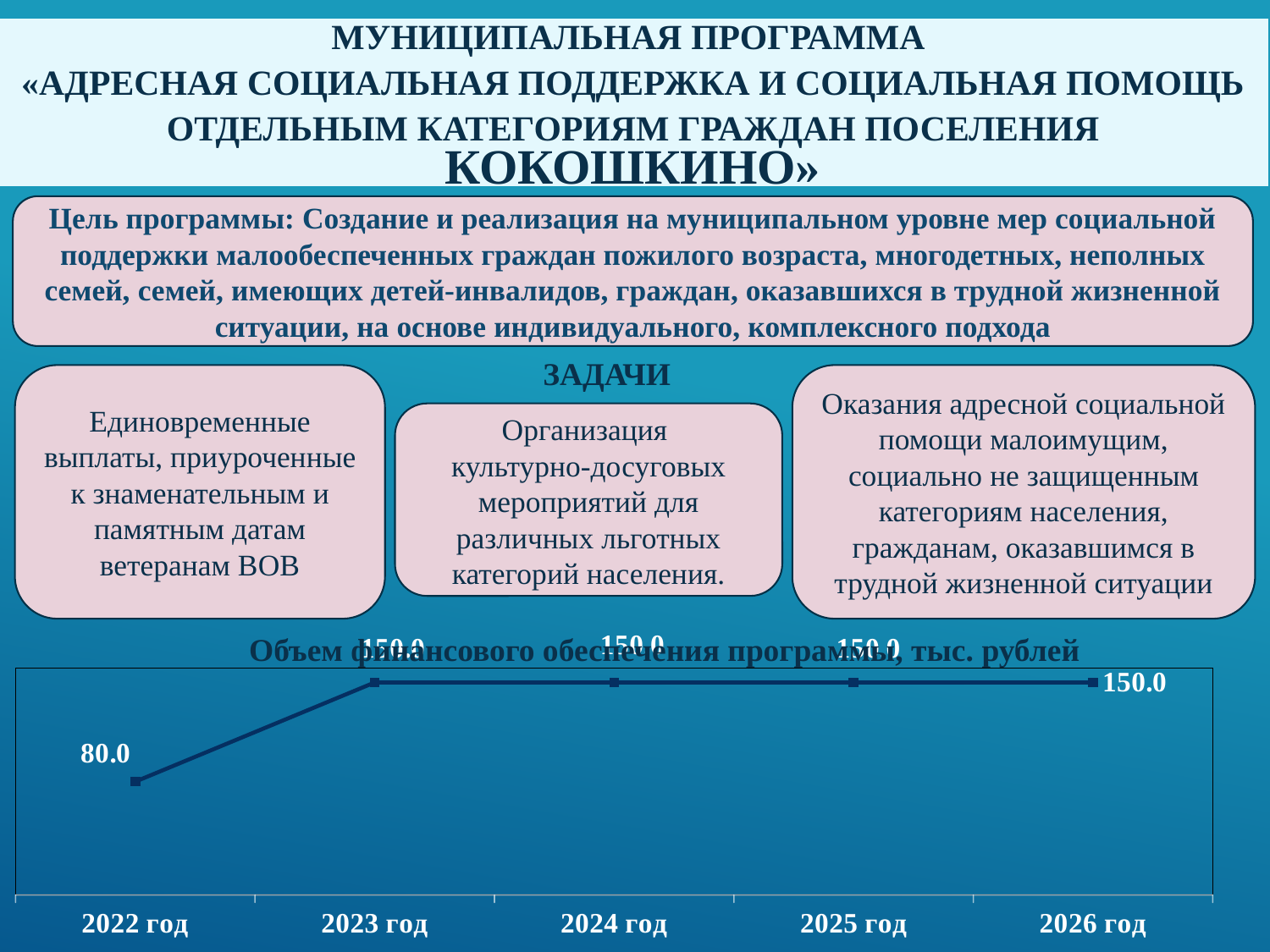
In the chart 'Объем финансового обеспечения программы, тыс. рублей', does the value change from 2023 год to 2026 год? No, it stays at 150.0 What is the difference between the values for 2023 год and 2022 год in the chart 'Объем финансового обеспечения программы, тыс. рублей'? 70.0 What is the value for 2024 год in the chart 'Объем финансового обеспечения программы, тыс. рублей'? 150.0 In the chart 'Объем финансового обеспечения программы, тыс. рублей', does the value rise, fall or stay the same from 2022 год to 2023 год? rise Which year has the lowest value in the chart 'Объем финансового обеспечения программы, тыс. рублей'? 2022 год How many years are plotted in the chart 'Объем финансового обеспечения программы, тыс. рублей'? 5 What is the value for 2022 год in the chart 'Объем финансового обеспечения программы, тыс. рублей'? 80.0 Which is larger in the chart 'Объем финансового обеспечения программы, тыс. рублей': the value for 2022 год or the value for 2025 год? 2025 год What kind of chart is 'Объем финансового обеспечения программы, тыс. рублей'? line chart What is the first year shown on the x axis of the chart 'Объем финансового обеспечения программы, тыс. рублей'? 2022 год What is the title of the chart at the bottom of the slide? Объем финансового обеспечения программы, тыс. рублей What is the value for 2026 год in the chart 'Объем финансового обеспечения программы, тыс. рублей'? 150.0